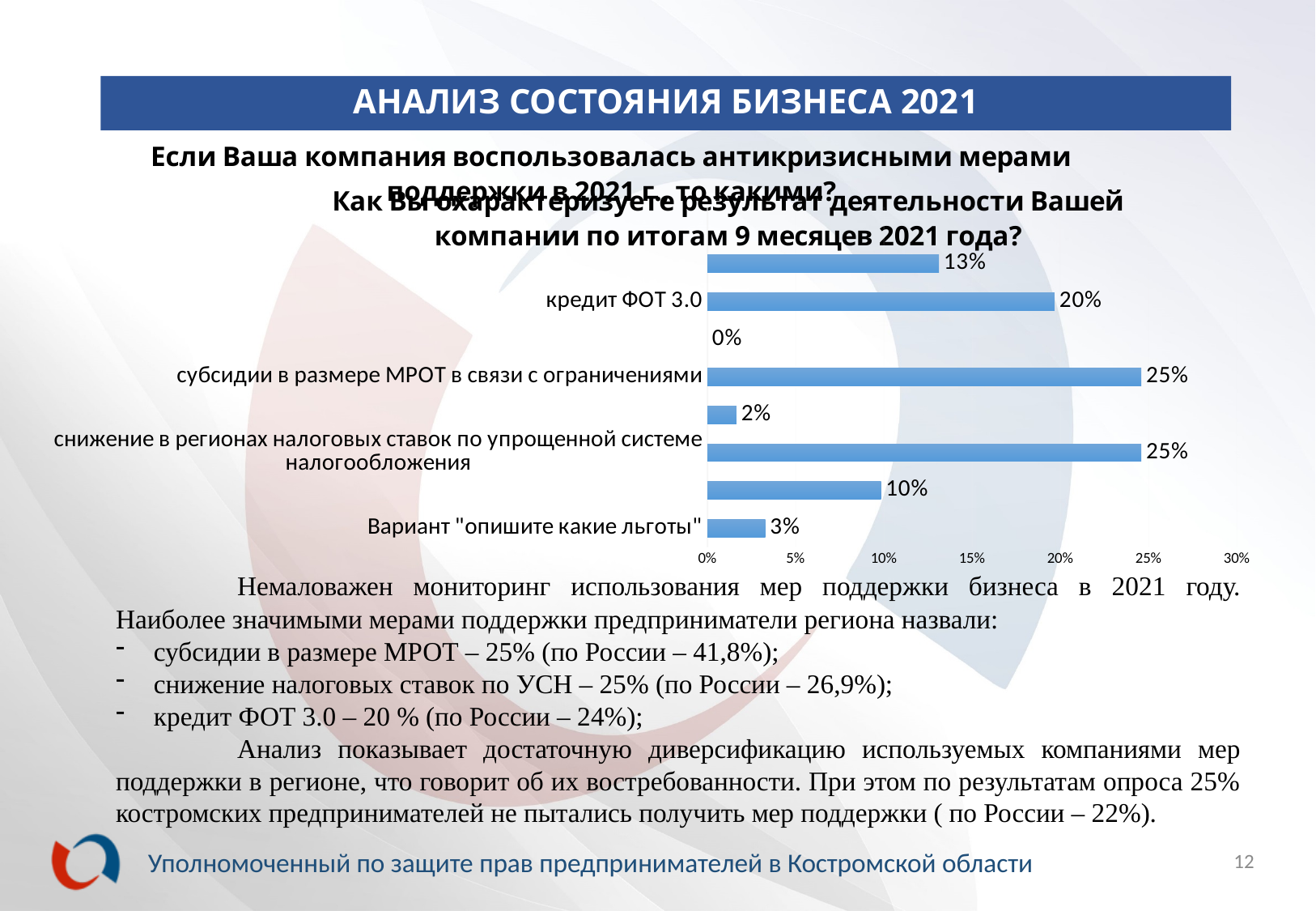
What is the value for "субсидии в размере МРОТ в связи с ограничениями"? 25% What is the value for "Вариант "опишите какие льготы""? 3% What is the highest value shown on any bar in the chart? 25% What is the value for "снижение в регионах налоговых ставок по упрощенной системе налогообложения"? 25% How many bars are plotted in the chart? 8 What is the value for "кредит ФОТ 3.0"? 20% What kind of chart is shown on the slide? bar chart What is the maximum value shown on the horizontal axis of the chart? 30% What is the difference between the values for "кредит ФОТ 3.0" and "Вариант "опишите какие льготы""? 17% Is the value for "кредит ФОТ 3.0" greater or less than 15%? greater What is the lowest value shown on any bar in the chart? 0% Which is larger, the value for "кредит ФОТ 3.0" or the value for "субсидии в размере МРОТ в связи с ограничениями"? субсидии в размере МРОТ в связи с ограничениями